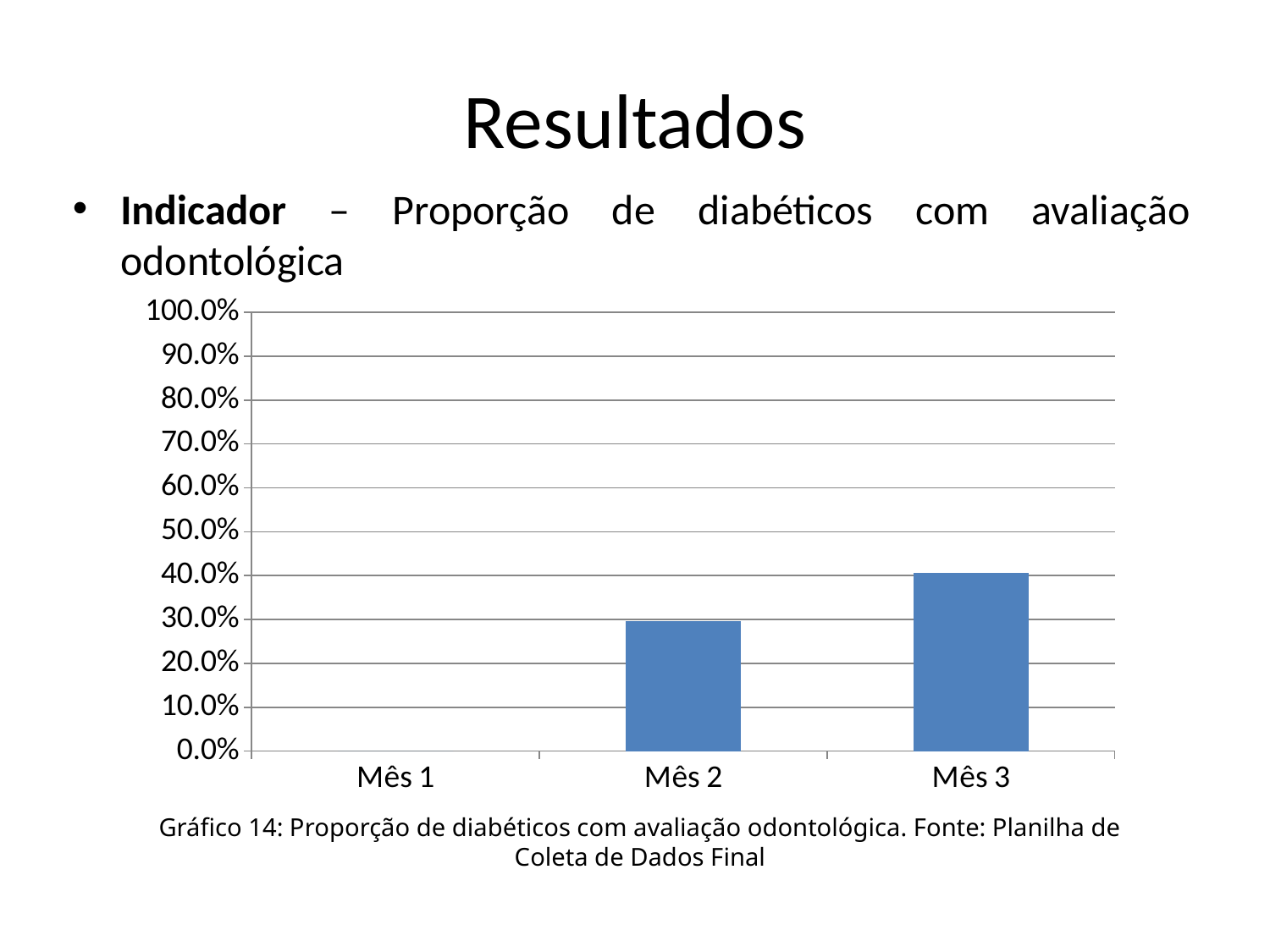
Which month has the highest proportion of diabetics with dental evaluation? Mês 3 Is the value for Mês 2 greater or less than 40.0%? less Which is larger, the value for Mês 2 or the value for Mês 3? Mês 3 What is the number of the graph given in the caption below the chart? Gráfico 14 Do the values rise or fall from Mês 1 to Mês 3? rise Is the value for Mês 3 greater or less than 50.0%? less Is the value for Mês 2 greater or less than 20.0%? greater Which month has the lowest proportion of diabetics with dental evaluation? Mês 1 How many categories are shown on the x axis of the chart? 3 What is the value shown for Mês 1? 0.0% What kind of chart is shown on the slide? bar chart